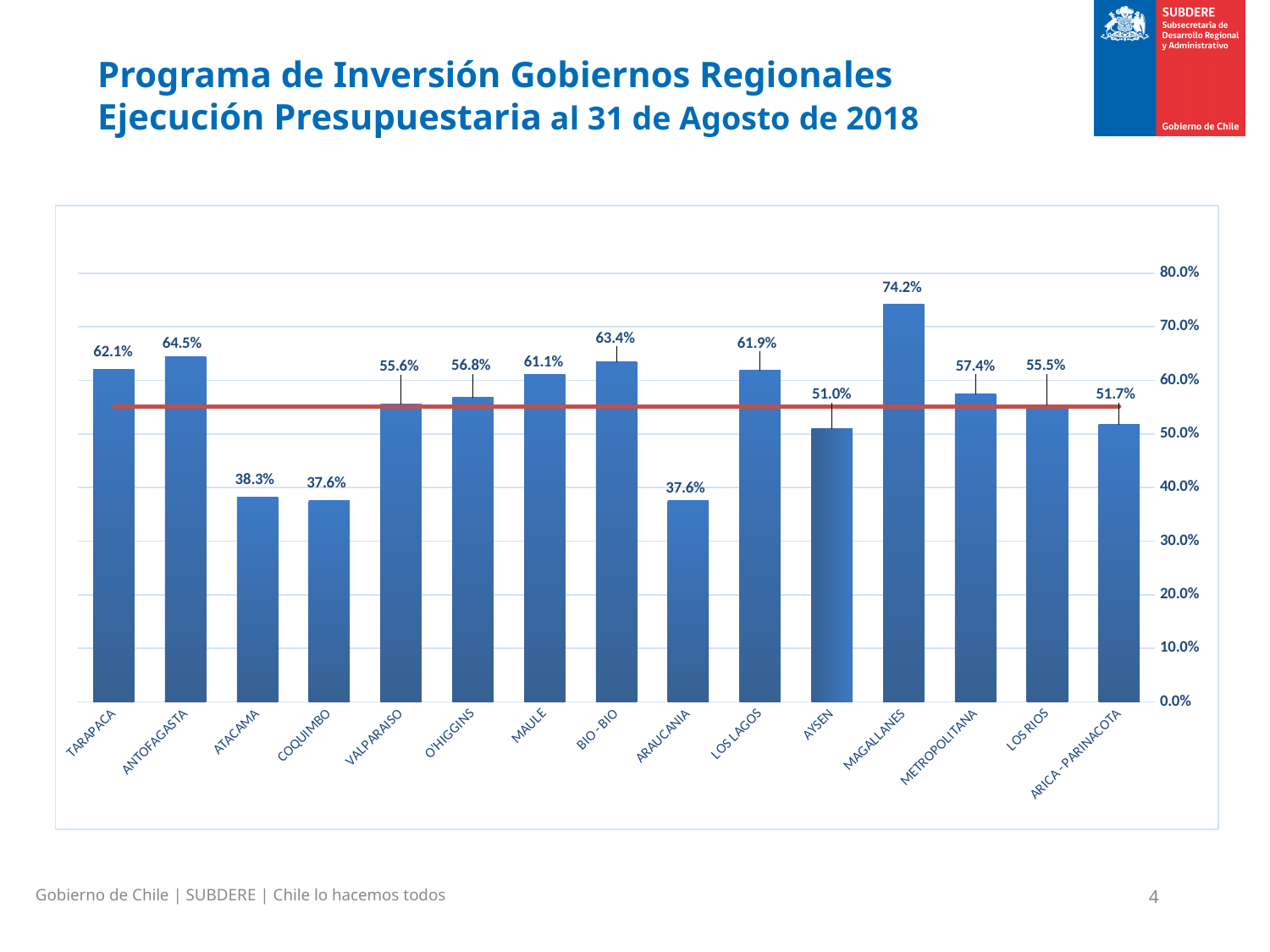
Is the value for AYSEN greater or less than 60.0%? less Which region has the highest value? MAGALLANES What kind of chart is shown on the slide? bar chart How many regions are shown on the chart? 15 What is the value for ATACAMA? 38.3% What is the value for MAGALLANES? 74.2% What is the difference between the values for MAGALLANES and AYSEN? 23.2% Which has a larger value, BIO - BIO or MAULE? BIO - BIO What is the lowest value shown on the chart? 37.6% What is the value for ARICA - PARINACOTA? 51.7% What is the value for LOS LAGOS? 61.9% What colour is the horizontal reference line drawn across the bars? red